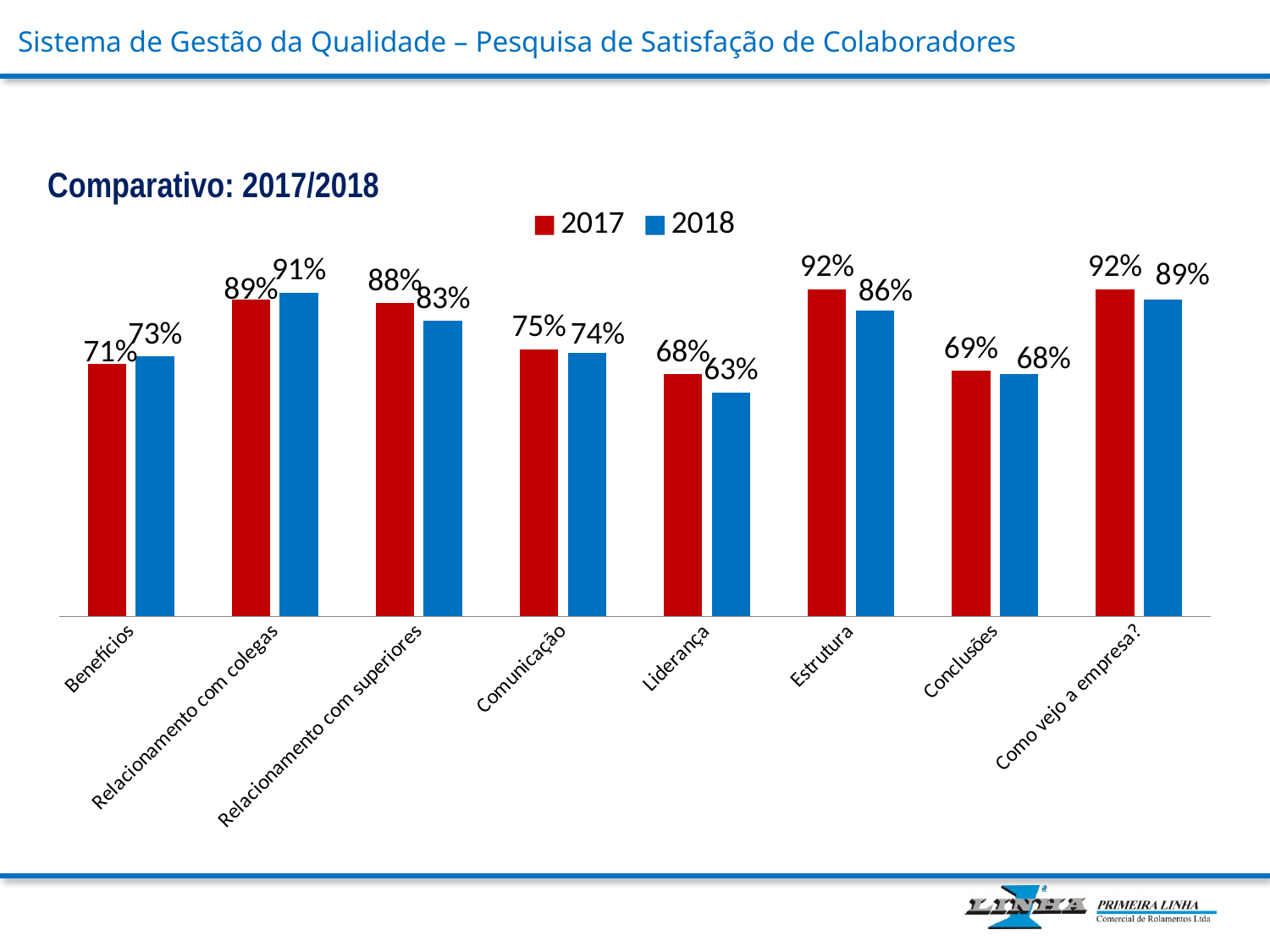
What is the 2018 value for Liderança? 63% How many series does the legend list? 2 What kind of chart is shown? Bar chart Which colour represents the 2018 series? Blue What is the 2017 value for Benefícios? 71% How many categories are shown on the x axis? 8 What is the 2018 value for Relacionamento com superiores? 83% Which is larger for Comunicação, the 2017 value or the 2018 value? 2017 Which category has the highest 2018 value? Relacionamento com colegas What is the difference between the 2017 and 2018 values for Estrutura? 6% Which category has the lowest 2018 value? Liderança What is the difference between the 2018 and 2017 values for Relacionamento com colegas? 2%